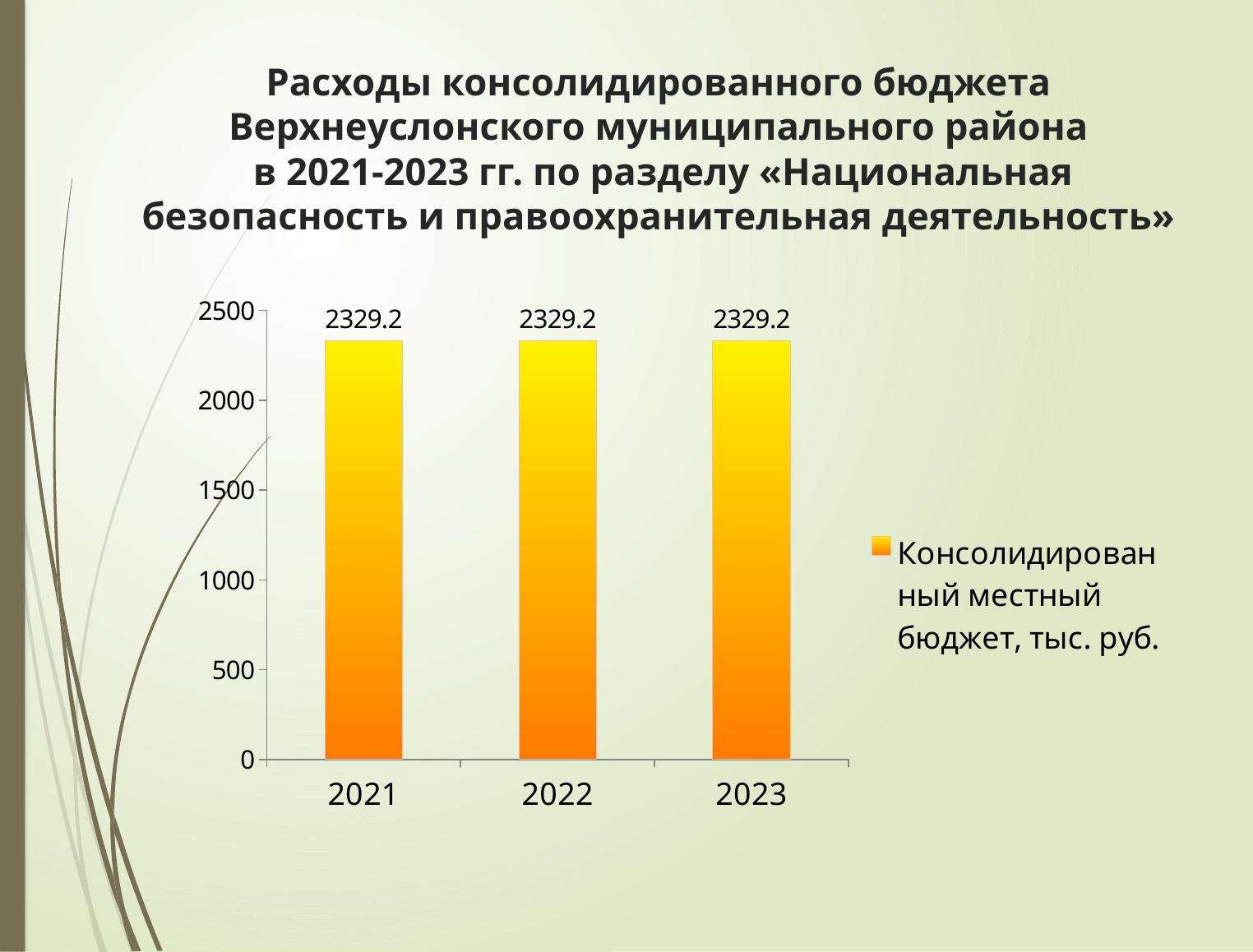
What is the value for 2021? 2329.2 How many years are shown on the x axis? 3 How many series does the legend list? 1 What is the highest tick value on the vertical axis? 2500 Is the value for 2022 larger than, smaller than, or equal to the value for 2021? equal Is the value for 2023 greater or less than 2000? greater What is the difference between the values for 2023 and 2021? 0 What is the value for 2022? 2329.2 Do the values rise, fall or stay the same from 2021 to 2023? stay the same What kind of chart is shown on the slide? bar chart What is the value for 2023? 2329.2 What series name does the legend show? Консолидированный местный бюджет, тыс. руб.